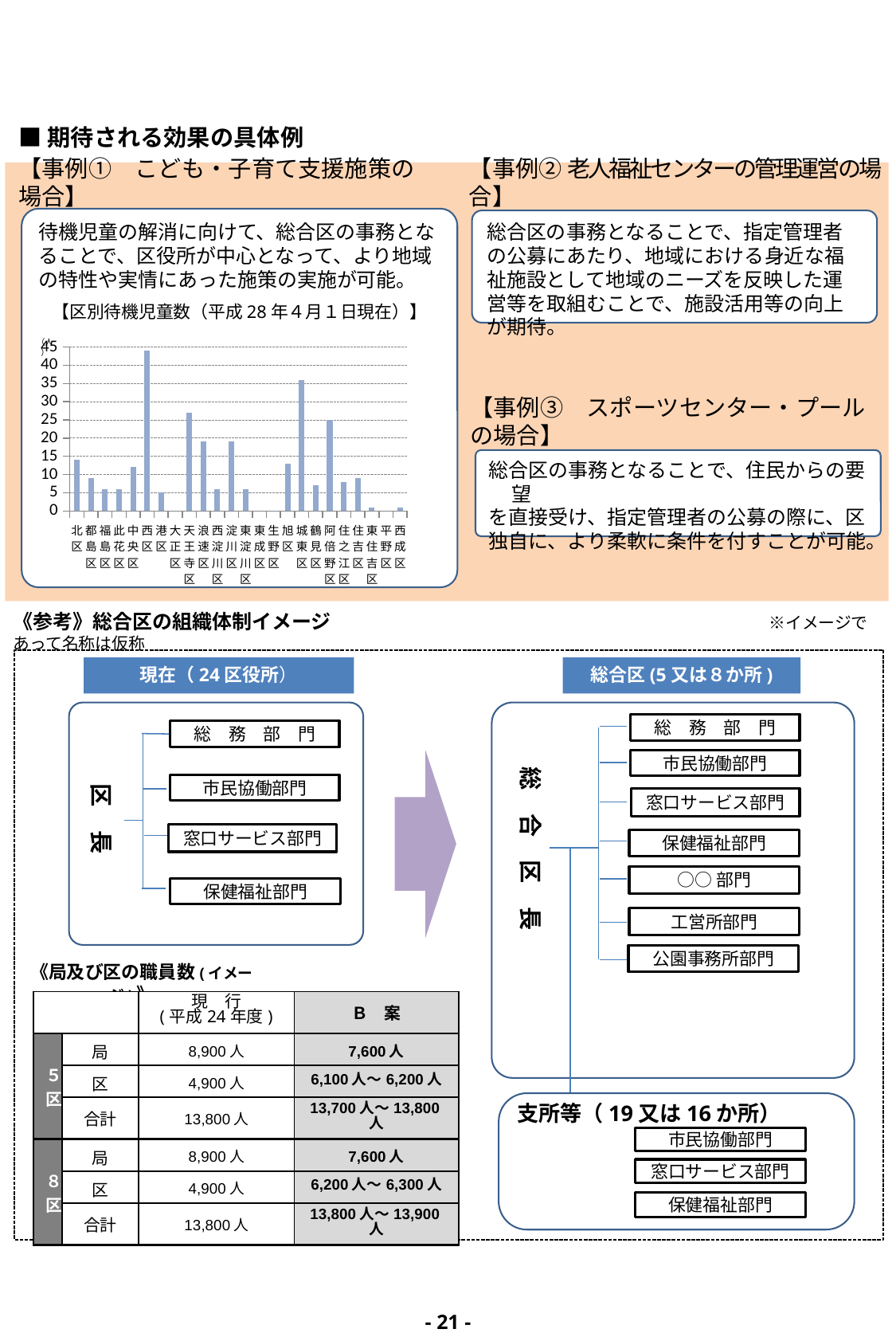
In the 区別待機児童数 chart, is the value for 港区 greater or less than 10? less In the 区別待機児童数 chart, is the value for 北区 greater or less than 20? less In the 区別待機児童数 chart, which ward has the highest number of waiting children? 西区 In the 区別待機児童数 chart, is the value for 城東区 greater or less than 30? greater How many wards (categories) are plotted in the 区別待機児童数 chart? 24 What is the title of the bar chart on the slide? 区別待機児童数（平成28年4月1日現在） In the 区別待機児童数 chart, which has more waiting children, 阿倍野区 or 住之江区? 阿倍野区 In the 区別待機児童数 chart, which has more waiting children, 西区 or 城東区? 西区 What is the highest tick value shown on the vertical axis of the 区別待機児童数 chart? 45 What kind of chart is used to show 区別待機児童数 (平成28年4月1日現在)? bar chart